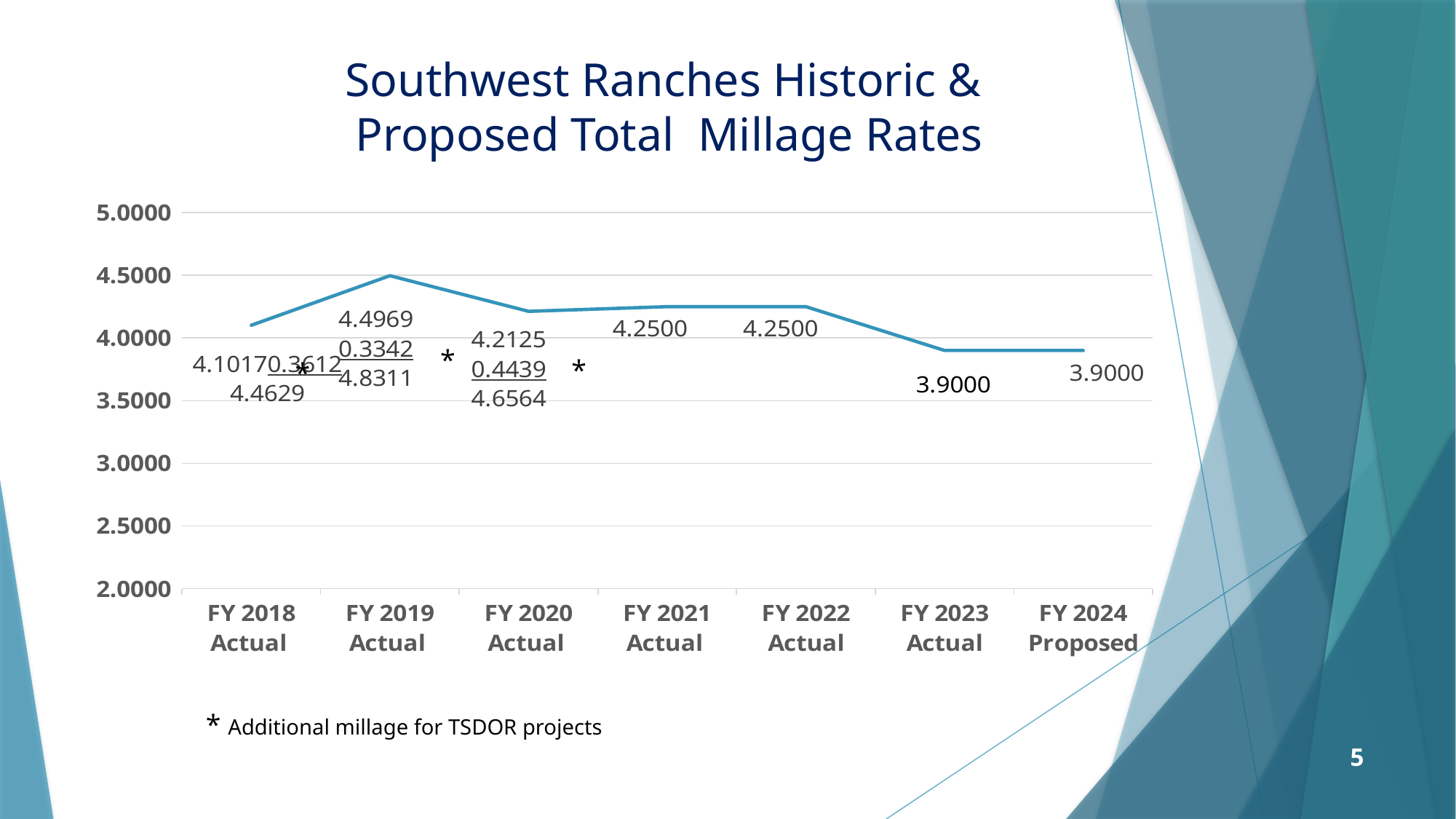
Which is larger, the plotted millage rate for FY 2018 Actual or FY 2022 Actual? FY 2022 Actual What is the title of the chart? Southwest Ranches Historic & Proposed Total Millage Rates What is the total millage rate plotted for FY 2021 Actual? 4.2500 Is the plotted millage rate for FY 2023 Actual greater or less than 4.0000? less What is the total millage rate plotted for FY 2018 Actual? 4.1017 What is the difference between the plotted millage rate for FY 2019 Actual and FY 2020 Actual? 0.2844 What is the total millage rate plotted for FY 2019 Actual? 4.4969 Which fiscal year has the highest plotted millage rate? FY 2019 Actual How many fiscal years are shown on the x axis? 7 What is the total millage rate plotted for FY 2024 Proposed? 3.9000 What type of chart is shown on the slide? line chart Does the plotted millage rate rise or fall from FY 2022 Actual to FY 2023 Actual? fall